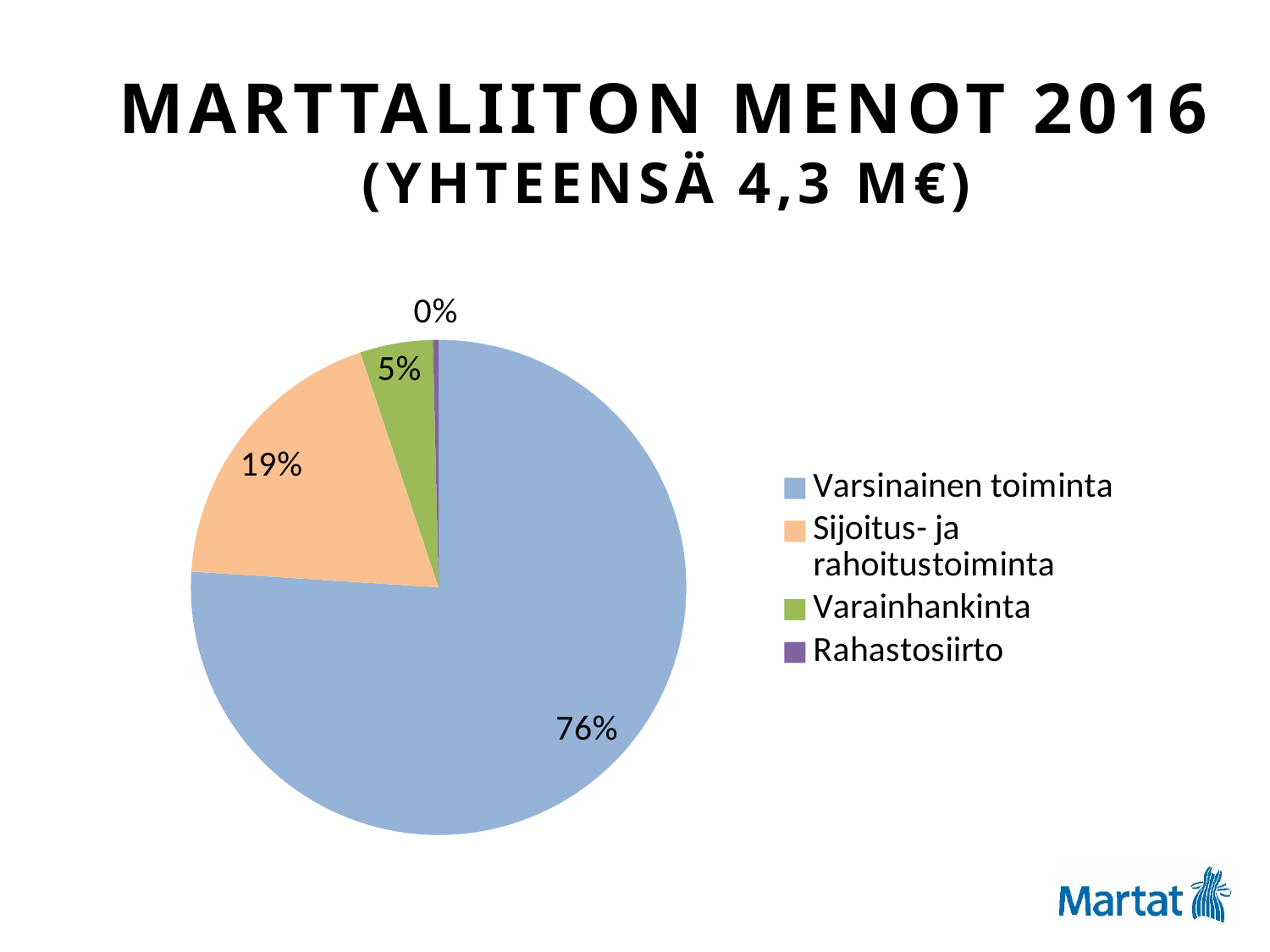
What is the difference in percentage points between Varsinainen toiminta and Sijoitus- ja rahoitustoiminta? 57 How many categories does the legend list? 4 Which is larger, the share for Sijoitus- ja rahoitustoiminta or the share for Varainhankinta? Sijoitus- ja rahoitustoiminta What share of the pie does Sijoitus- ja rahoitustoiminta take? 19% Which category has the smallest slice of the pie? Rahastosiirto What is the title of the chart on the slide? MARTTALIITON MENOT 2016 (YHTEENSÄ 4,3 M€) What share of the pie does Varsinainen toiminta take? 76% What colour is the slice for Varainhankinta? green What share of the pie does Rahastosiirto take? 0% What kind of chart is shown on the slide? pie chart Which category has the largest slice of the pie? Varsinainen toiminta